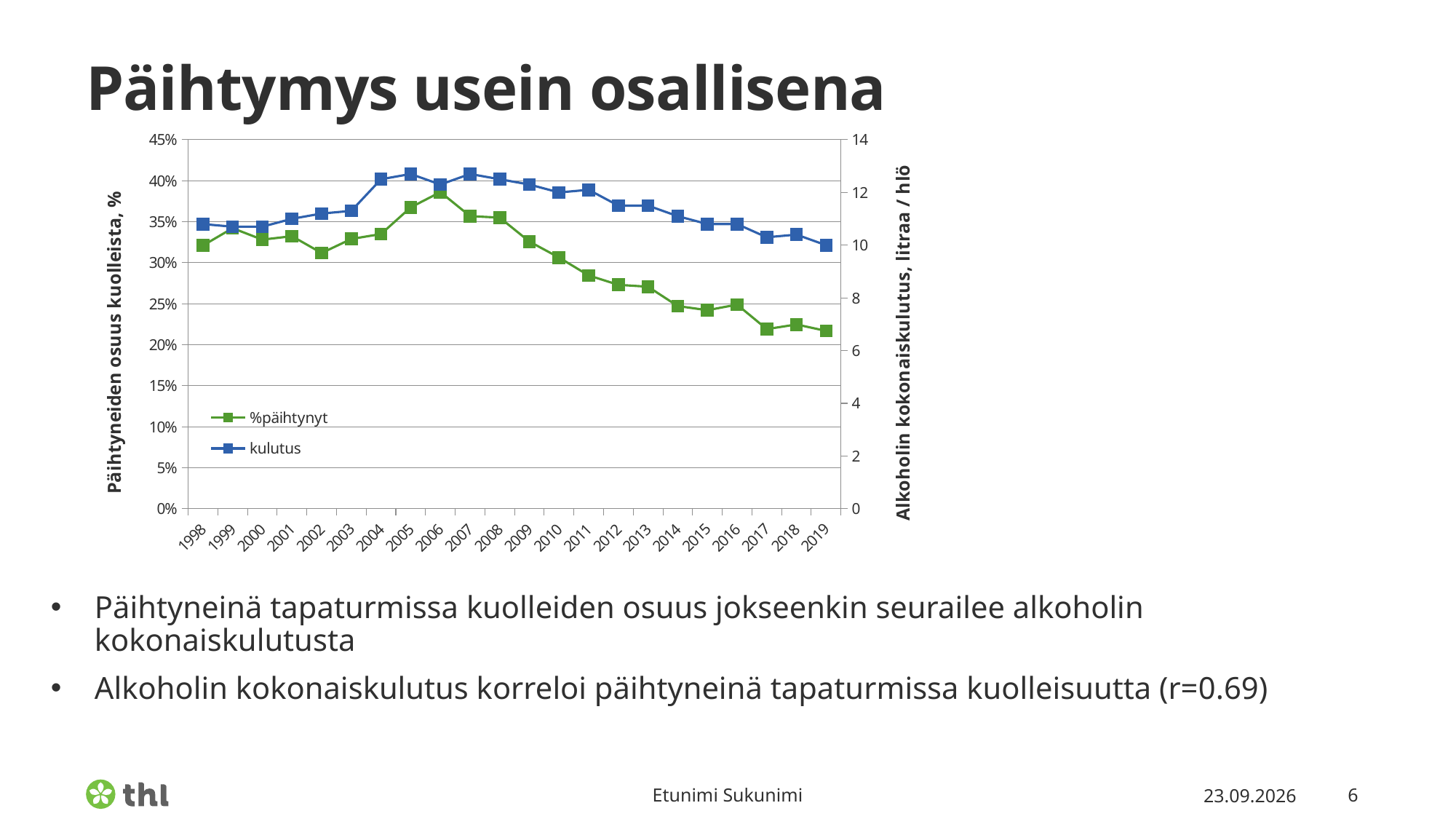
Is the %päihtynyt value for 2006 greater or less than 35%? greater Does the %päihtynyt series rise or fall from 2006 to 2019? fall Is the kulutus value for 2005 greater or less than 12? greater What is the title of the right-hand vertical axis of the chart? Alkoholin kokonaiskulutus, litraa / hlö What kind of chart is shown on the slide? line chart Is the kulutus value for 2019 greater or less than 12? less In which year does the %päihtynyt series reach its highest value? 2006 How many years are plotted along the x axis of the chart? 22 Which year has the larger kulutus value, 2004 or 2019? 2004 Which year has the larger %päihtynyt value, 2006 or 2016? 2006 How many series does the chart legend list? 2